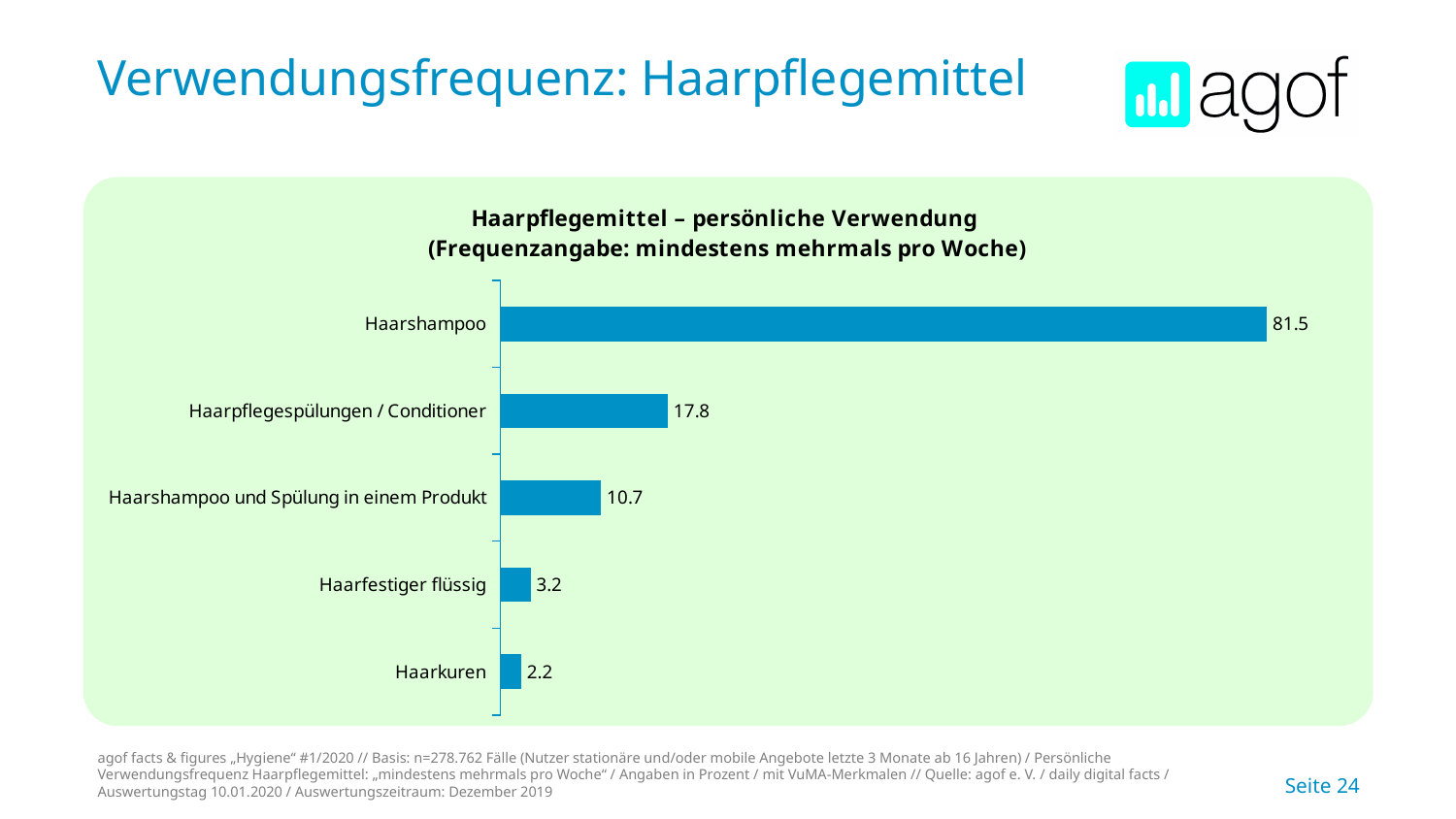
What is the value for Haarpflegespülungen / Conditioner? 17.8 What is the value for Haarfestiger flüssig? 3.2 What is the title of the chart? Haarpflegemittel – persönliche Verwendung (Frequenzangabe: mindestens mehrmals pro Woche) What is the value for Haarshampoo und Spülung in einem Produkt? 10.7 How many categories are shown in the chart? 5 What kind of chart is shown on the slide? Bar chart Which is larger, the value for Haarfestiger flüssig or the value for Haarkuren? Haarfestiger flüssig Which category has the lowest value? Haarkuren What is the value for Haarkuren? 2.2 Which category has the highest value? Haarshampoo What is the value for Haarshampoo? 81.5 What is the difference between the values for Haarshampoo and Haarpflegespülungen / Conditioner? 63.7